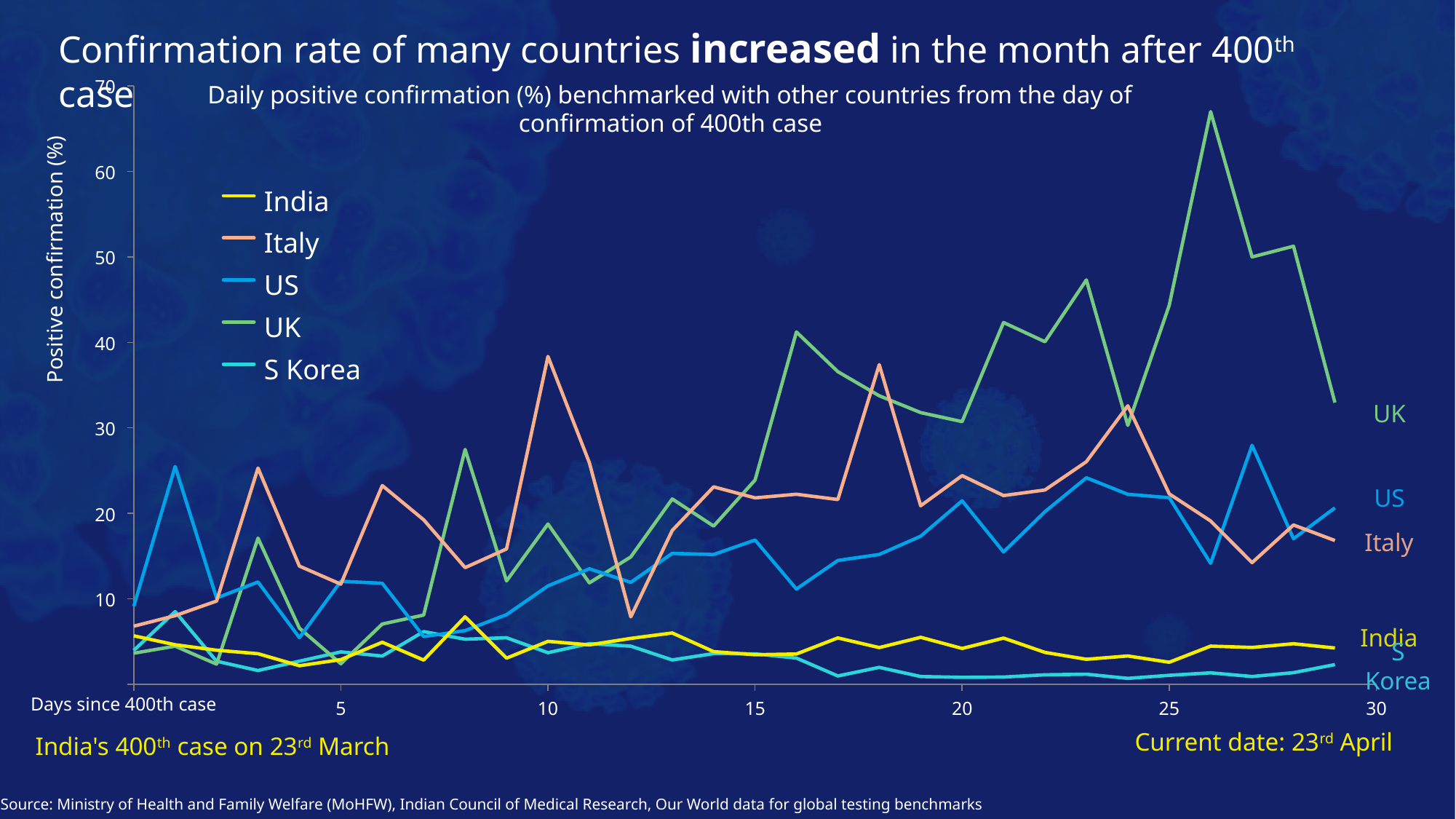
What is the label of the y axis? Positive confirmation (%) At day 26, which is larger, the value for the UK or the value for India? UK Which country's line reaches the highest value on the chart? UK Does the UK line generally rise or fall from day 1 to day 26? rise Which countries are listed in the chart legend? India, Italy, US, UK, S Korea Is the peak value for the UK (around day 26) greater or less than 60? greater How many series does the legend list? 5 Is the value for India at day 30 greater or less than 10? less Is the value for S Korea at day 25 greater or less than 10? less Which country's line is lowest at day 30? S Korea What kind of chart is shown on the slide? Line chart